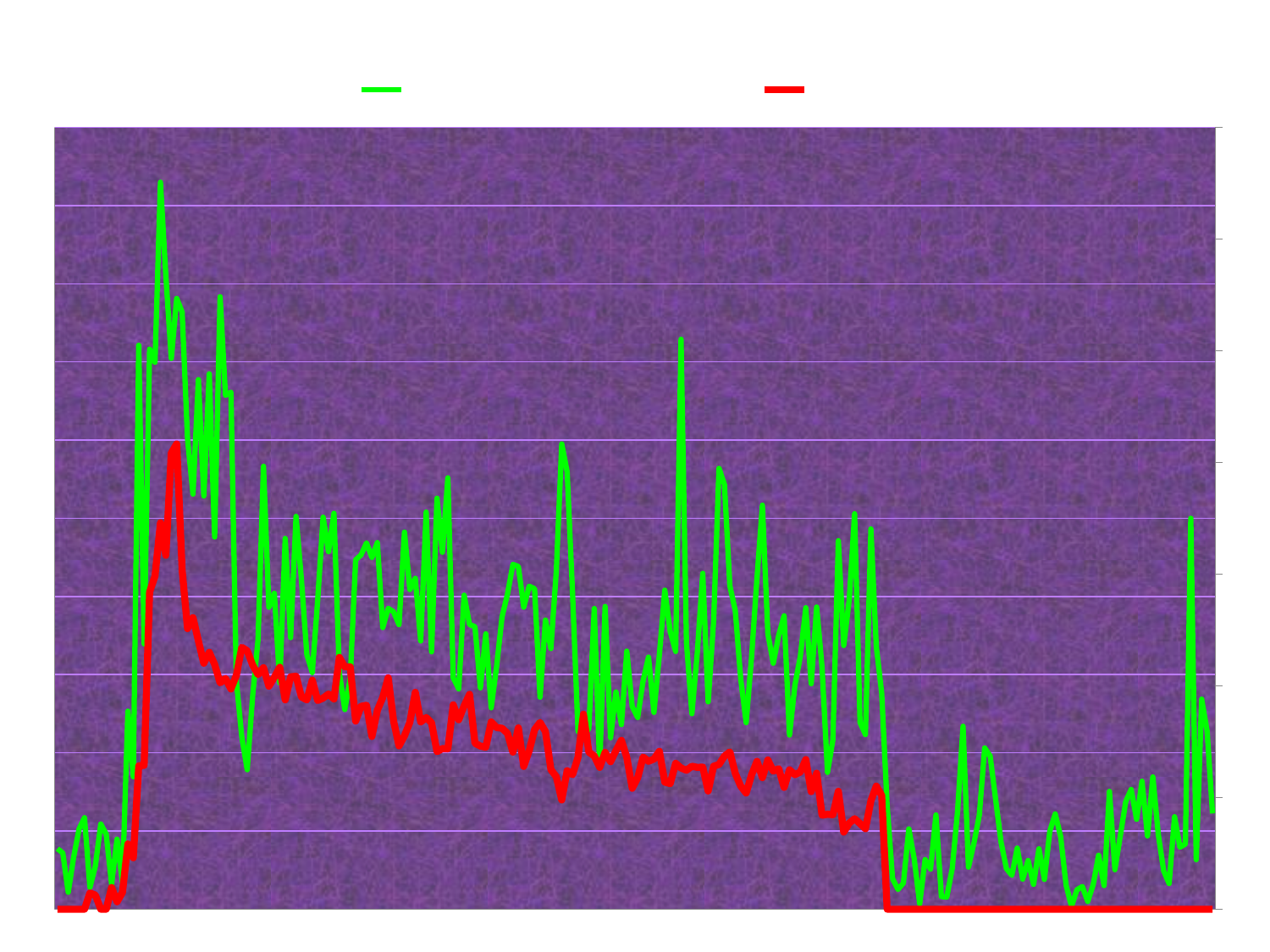
What colours are the two lines plotted on the chart? green and red How many series does the legend list? 2 What kind of chart is shown on the slide? line chart Which line is flat along the bottom of the chart over the right-hand portion, the green line or the red line? red Which line reaches the highest peak on the chart, the green line or the red line? green Which line is higher at the far right end of the chart, the green line or the red line? green